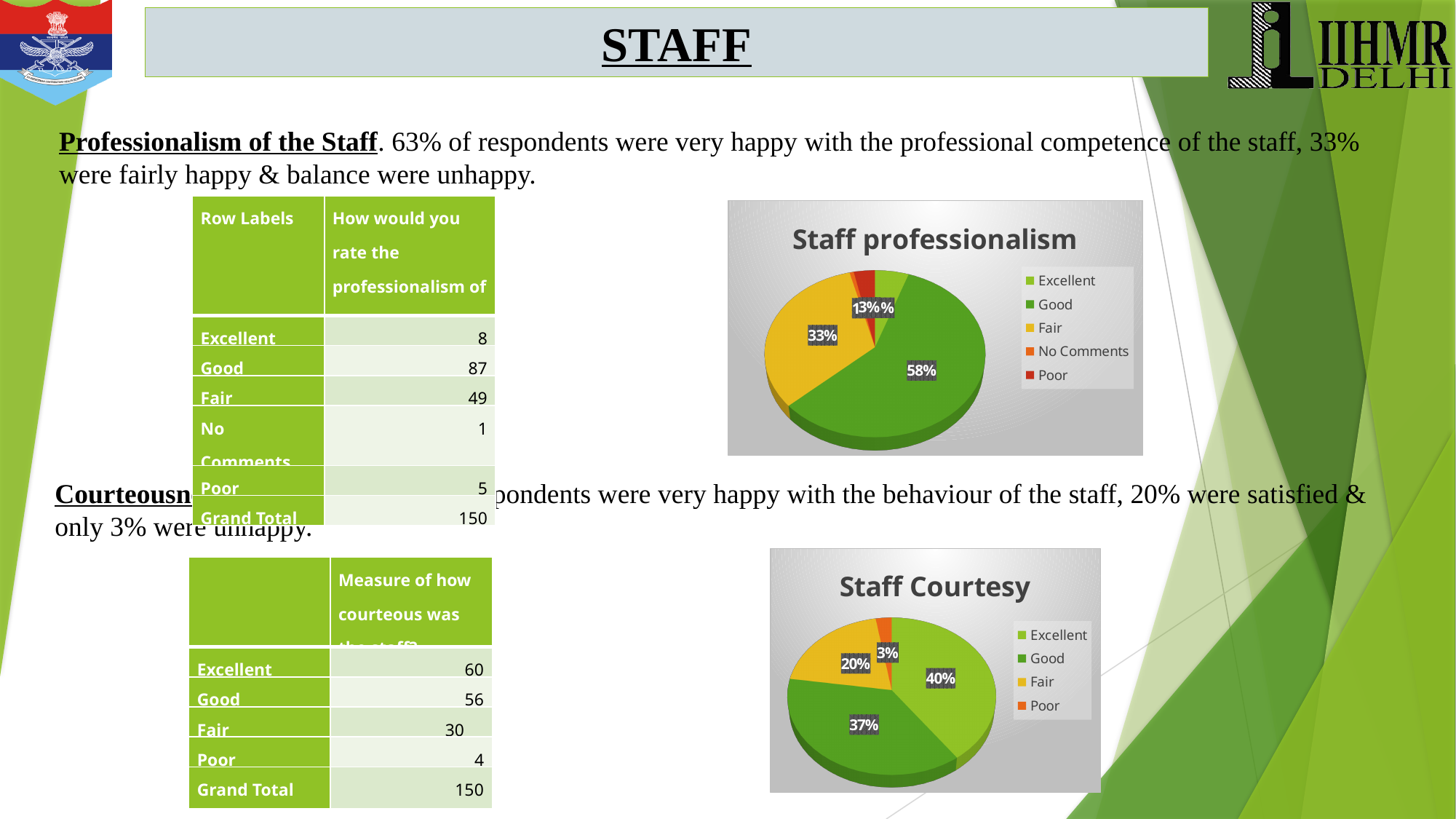
In the Staff professionalism chart, what share of the pie is labelled for Good? 58% In the Staff professionalism chart, which category has the largest slice? Good What kind of chart is the Staff professionalism chart? Pie chart In the Staff Courtesy chart, what share of the pie is labelled for Good? 37% How many entries does the legend of the Staff professionalism chart list? 5 In the Staff Courtesy chart, what is the difference between the Excellent and Fair shares? 20% In the Staff Courtesy chart, which category has the smallest slice? Poor In the Staff Courtesy chart, what share of the pie is labelled for Poor? 3% How many categories does the legend of the Staff Courtesy chart list? 4 In the Staff Courtesy chart, which is larger, the Fair slice or the Poor slice? Fair In the Staff Courtesy chart, what share of the pie is labelled for Excellent? 40% In the Staff professionalism chart, what share of the pie is labelled for Fair? 33%